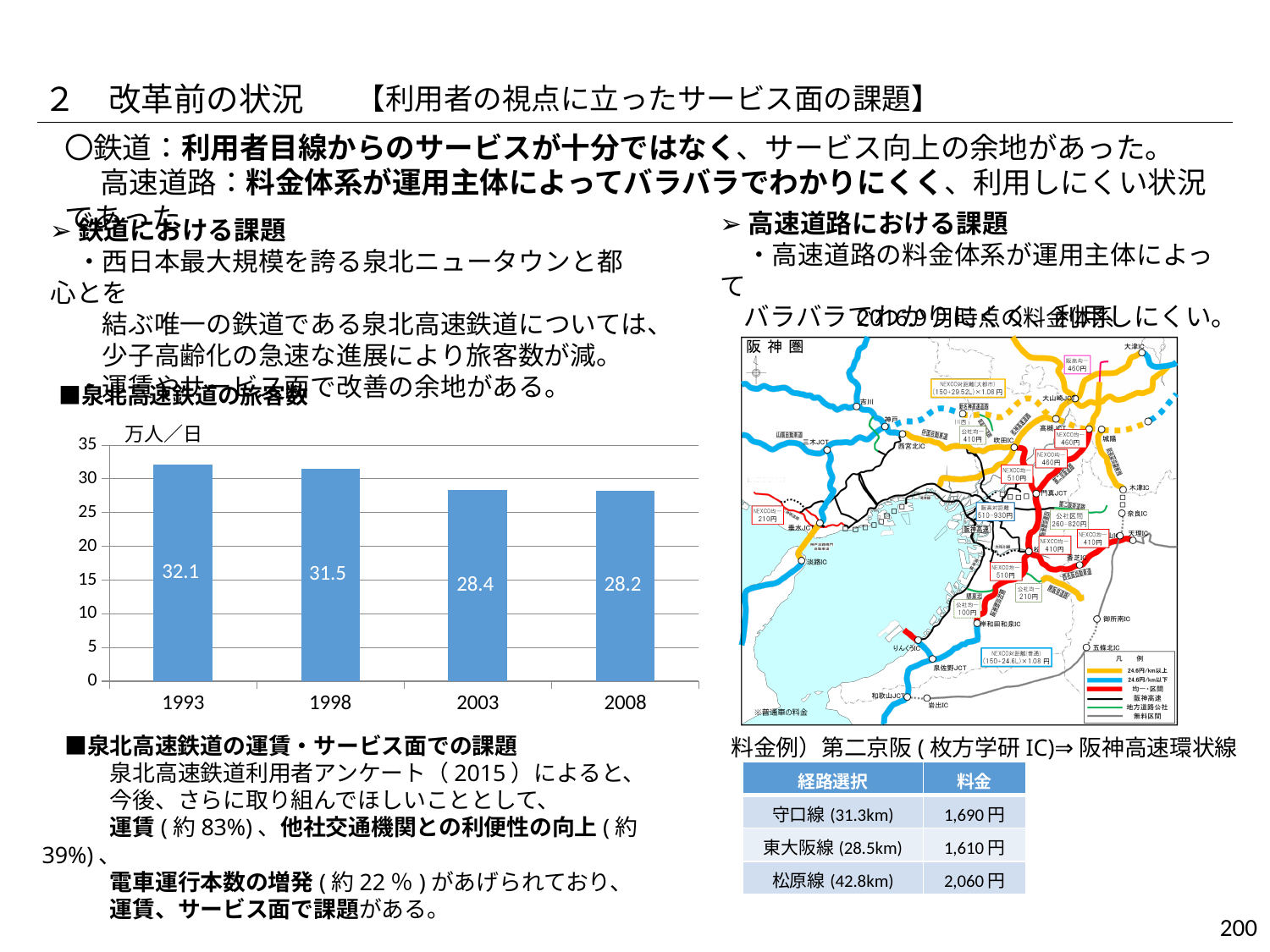
Which year has the lowest value in the 泉北高速鉄道の旅客数 chart? 2008 How many years are shown on the x axis of the 泉北高速鉄道の旅客数 chart? 4 What is the value for 2003 in the 泉北高速鉄道の旅客数 chart? 28.4 What is the value for 2008 in the 泉北高速鉄道の旅客数 chart? 28.2 What is the difference between the 1993 and 2008 values in the 泉北高速鉄道の旅客数 chart? 3.9 What is the difference between the 1998 and 2003 values in the 泉北高速鉄道の旅客数 chart? 3.1 What kind of chart is the 泉北高速鉄道の旅客数 chart? bar chart What is the value for 1993 in the 泉北高速鉄道の旅客数 chart? 32.1 In the 泉北高速鉄道の旅客数 chart, which is larger, the value for 1998 or the value for 2003? 1998 Which year has the highest value in the 泉北高速鉄道の旅客数 chart? 1993 Do the values in the 泉北高速鉄道の旅客数 chart rise or fall from 1993 to 2008? fall In the 泉北高速鉄道の旅客数 chart, is the value for 2003 greater or less than 30? less